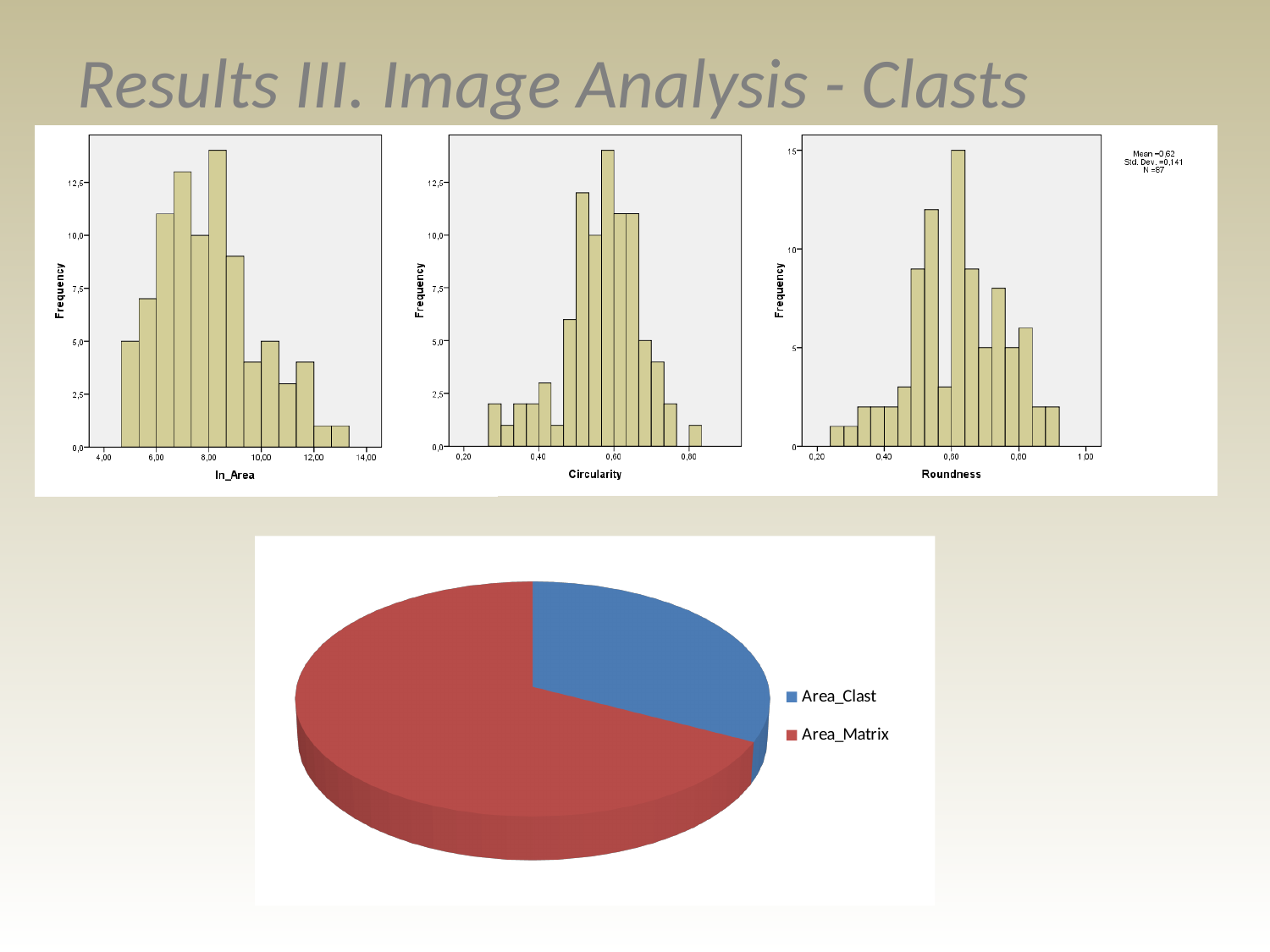
In the Roundness chart, what is the frequency of the tallest bar? 15 How many histogram charts are shown in the top row of the slide? 3 In the Roundness chart, is the frequency of the bar at 0,40 greater or less than 5? less In the pie chart at the bottom of the slide, which slice is larger, Area_Clast or Area_Matrix? Area_Matrix In the pie chart at the bottom of the slide, how many entries does the legend list? 2 What kind of chart is the Roundness chart at the top right of the slide? Bar chart What kind of chart is the chart at the bottom of the slide with the Area_Clast and Area_Matrix legend? Pie chart In the Circularity chart, is the frequency of the tallest bar greater or less than 12,5? greater In the Roundness chart, what value of N is printed in the text box beside the chart? 87 In the ln_Area chart, is the frequency of the tallest bar greater or less than 12,5? greater In the pie chart at the bottom of the slide, what colour is the Area_Clast slice? Blue In the pie chart at the bottom of the slide, which category has the smallest slice? Area_Clast